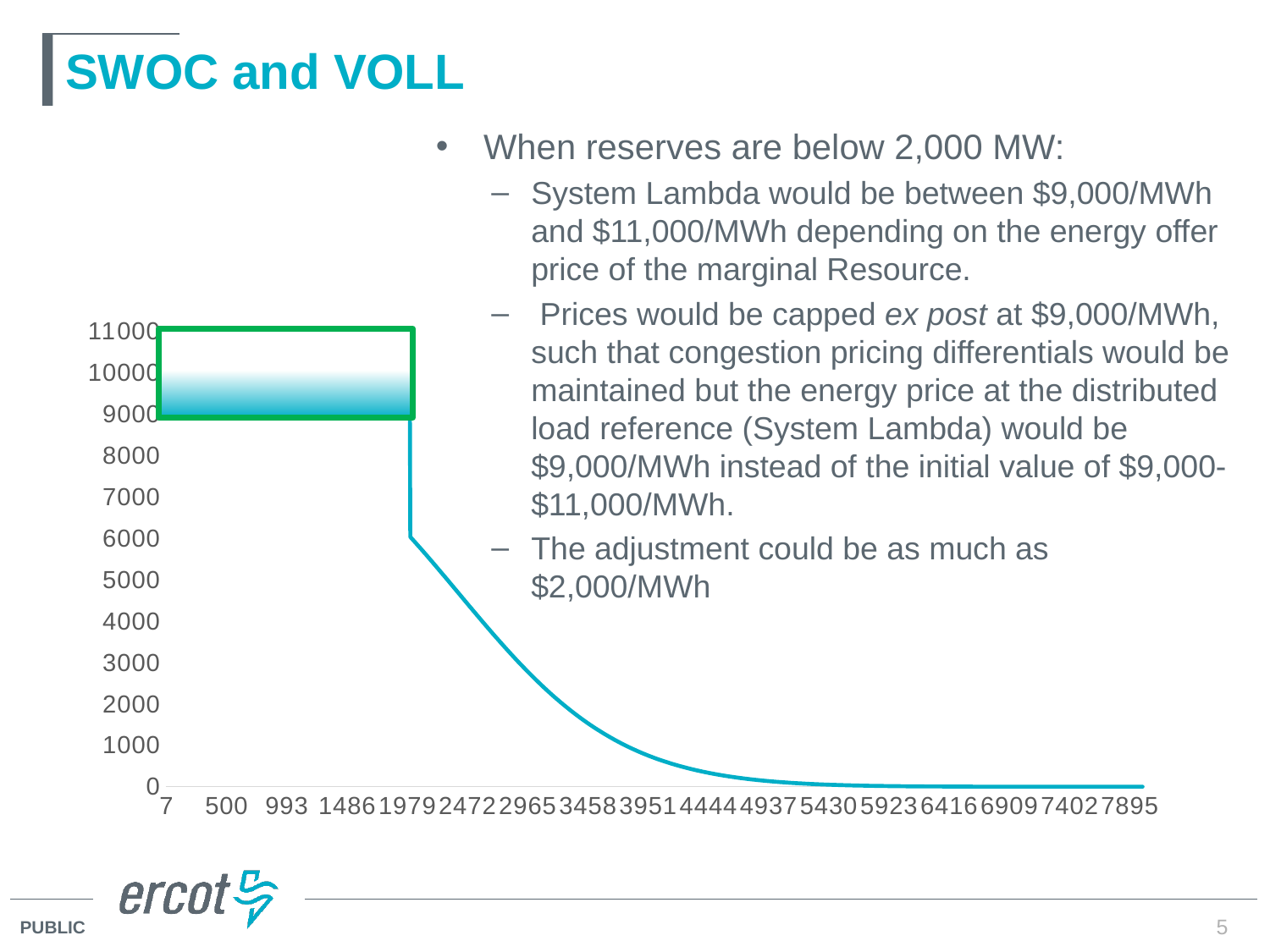
Is the value at x = 3951 greater or less than 2000? less Is the value at x = 7895 greater or less than 1000? less Between which two y-axis values does the green box on the chart span? 9000 and 11000 Is the value at x = 2472 greater or less than 6000? less Which has the larger value, x = 993 or x = 2965? 993 How many labels are shown along the x axis of the chart? 17 What is the highest tick value shown on the y axis? 11000 Do the plotted values rise or fall as you move from left to right along the x axis? fall Which has the larger value, x = 4444 or x = 1486? 1486 What kind of chart is shown on the slide? line chart